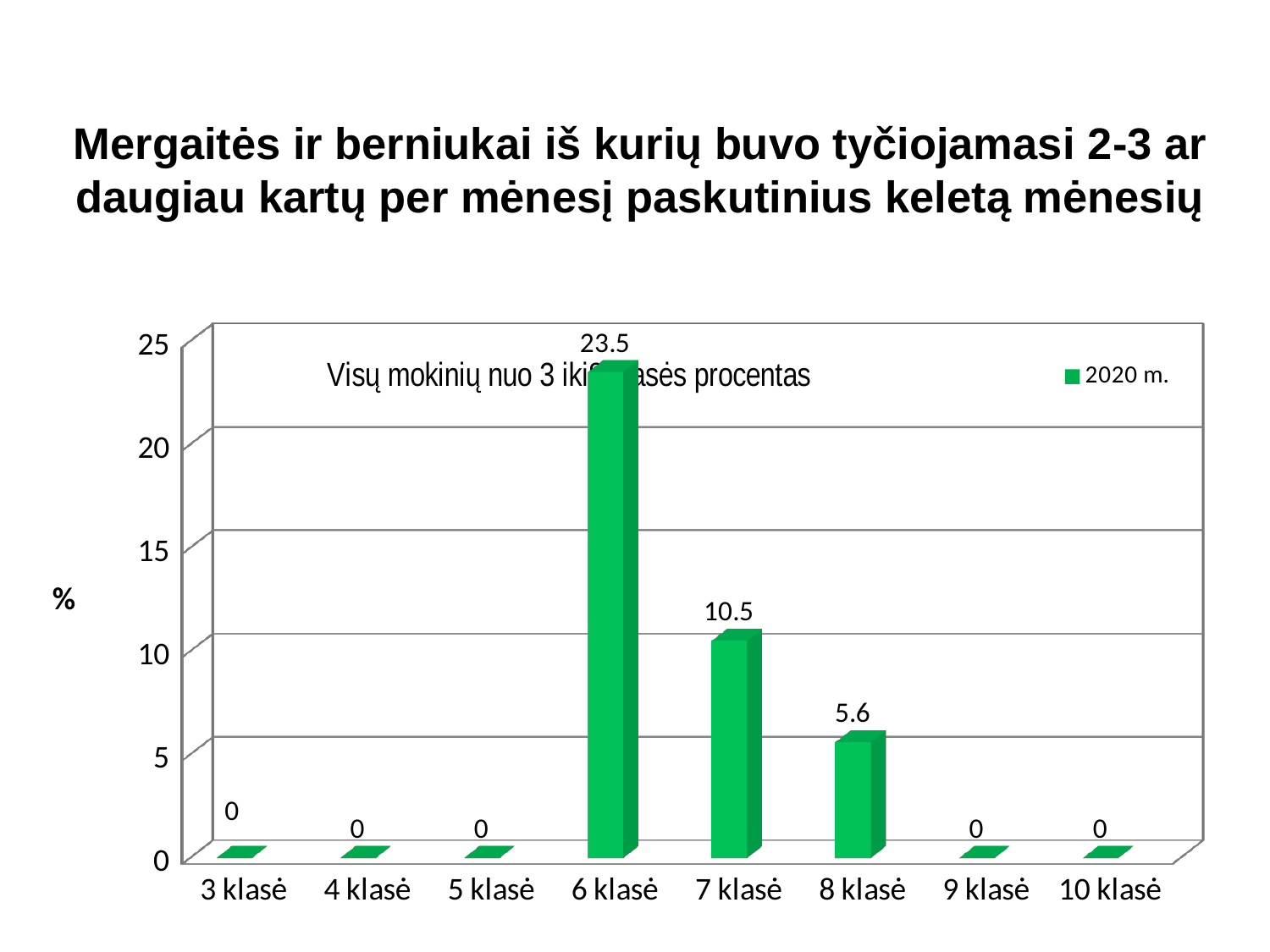
Is the value for 6 klasė greater or less than 20? greater What is the value for 8 klasė? 5.6 What is the value for 6 klasė? 23.5 What is the value for 7 klasė? 10.5 What is the difference between the values for 6 klasė and 7 klasė? 13 What kind of chart is shown on the slide? bar chart Which category has the highest value? 6 klasė What is the value for 4 klasė? 0 How many categories are shown on the x axis? 8 How many series does the legend list? 1 Which is larger, the value for 7 klasė or the value for 8 klasė? 7 klasė What is the difference between the values for 7 klasė and 8 klasė? 4.9